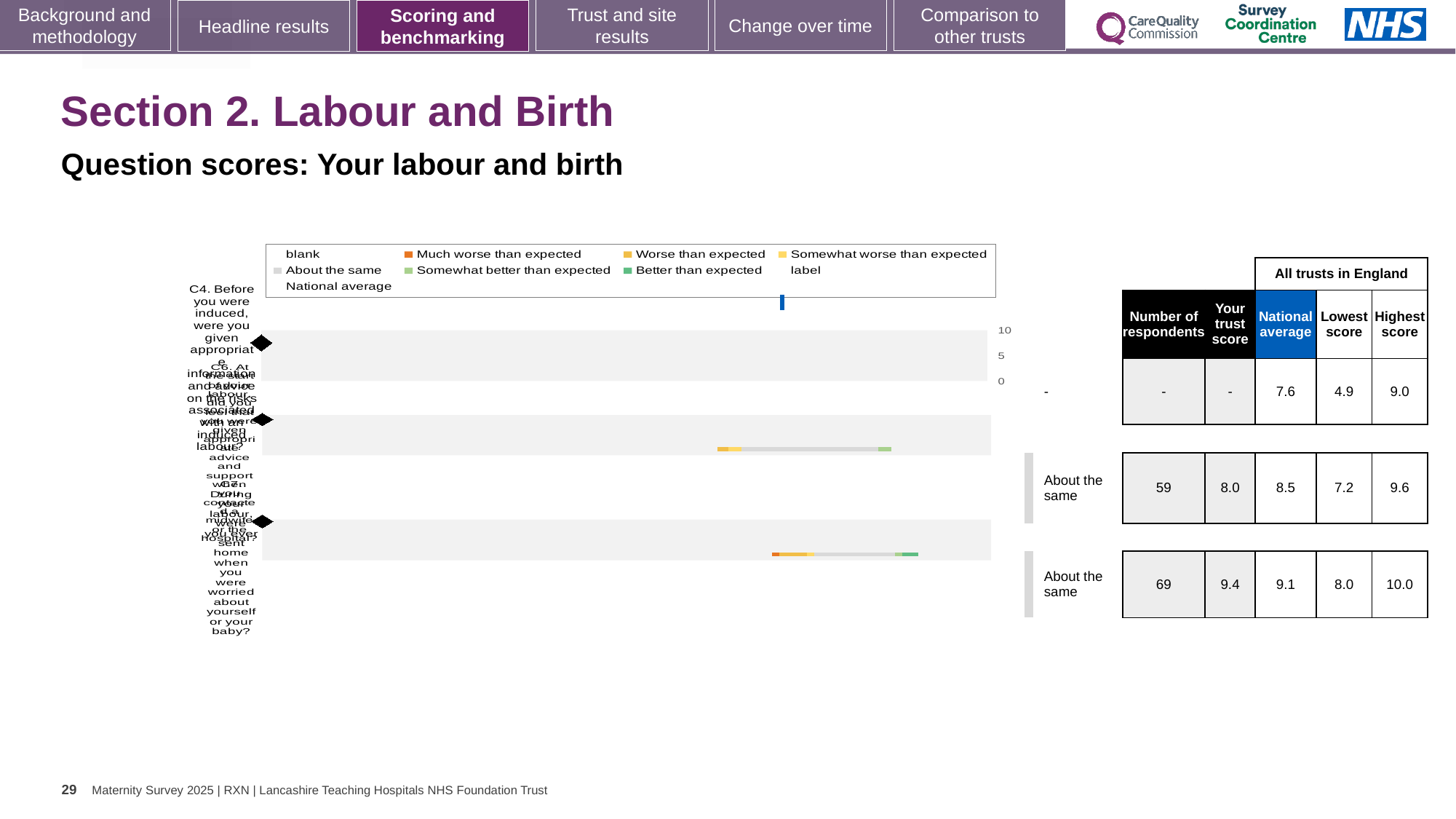
How many question rows are shown in the chart and table? 3 In the table, what is the national average for the first question row (C4)? 7.6 What is the maximum value shown on the chart's score axis? 10 For the third question row, which is larger: the trust score or the national average? trust score What is the difference between the highest score and the lowest score for the first question row (C4)? 4.1 Which question row has the lowest 'Lowest score' value in the table? the first row (C4), 4.9 What benchmark category is shown for the second question row? About the same In the table, what is the number of respondents for the second question row? 59 For the second question row, which is larger: the trust score or the national average? national average In the table, what is the trust score for the third question row? 9.4 What kind of chart is shown on the slide? bar chart In the table, what is the highest score for the third question row? 10.0